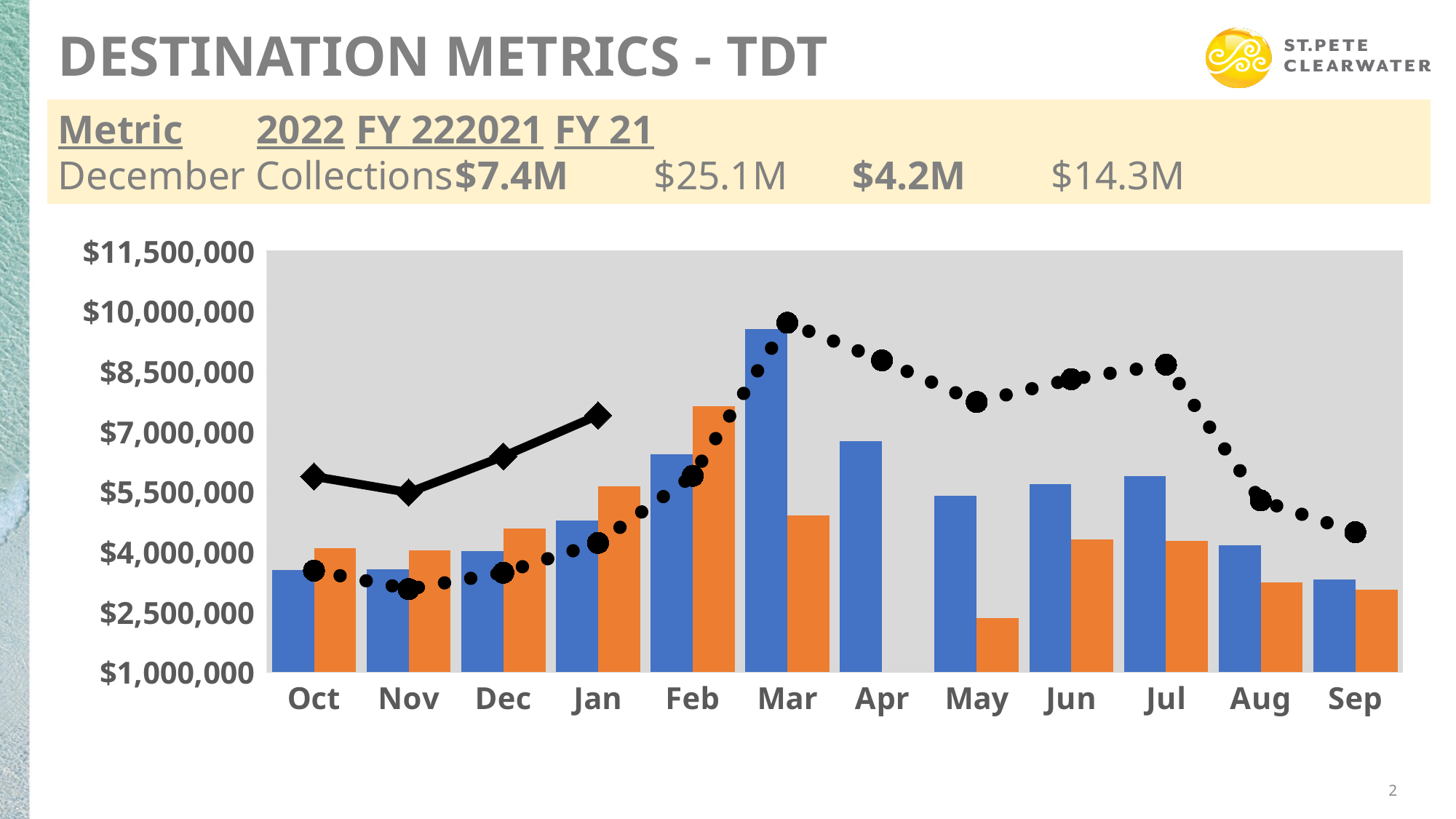
What kind of chart is shown on the slide? A bar chart with line series Which month has the tallest orange bar? Feb In Feb, which bar is taller, the blue bar or the orange bar? The orange bar Does the solid line with diamond markers rise or fall from Nov to Jan? It rises What is the title of the slide containing the chart? DESTINATION METRICS - TDT Is the orange bar for Sep greater or less than $4,000,000? less Is the orange bar for Feb greater or less than $7,000,000? greater In Mar, which bar is taller, the blue bar or the orange bar? The blue bar How many months are shown on the x axis of the chart? 12 Which month has the tallest blue bar? Mar Is the blue bar for Mar greater or less than $8,500,000? greater